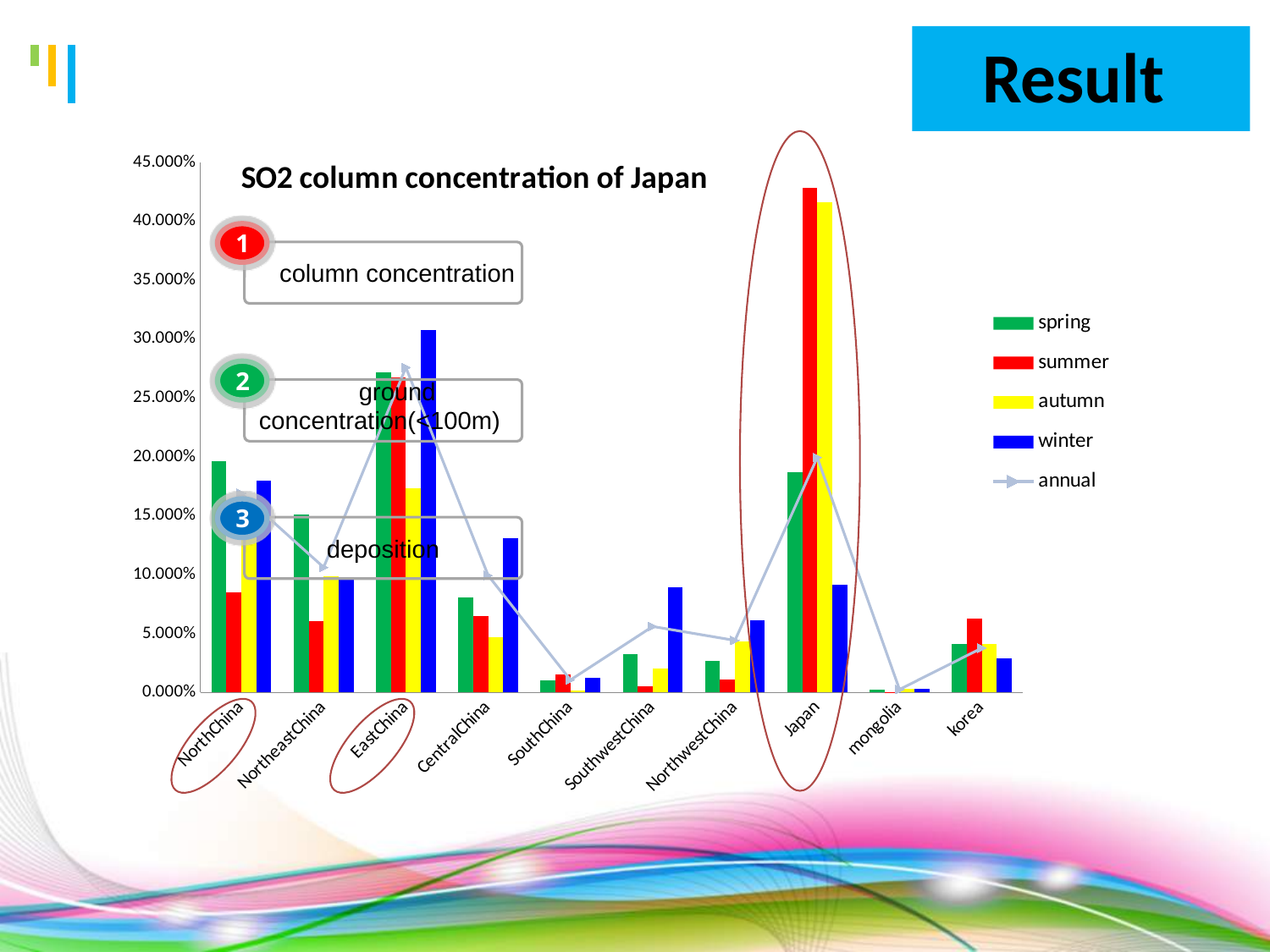
How many regions are shown along the x axis of the chart? 10 Which region has the highest winter value? EastChina For SouthwestChina, which is larger, the winter value or the spring value? winter Is the spring value for NorthChina greater or less than 20.000%? less Which region has the lowest values across all seasons? mongolia For NorthChina, which is larger, the spring value or the summer value? spring Is the summer value for Japan greater or less than 40.000%? greater Is the winter value for EastChina greater or less than 25.000%? greater What kind of chart is shown on the slide? combination bar and line chart How many series does the chart's legend list? 5 What is the title of the chart? SO2 column concentration of Japan Which region has the highest summer value? Japan